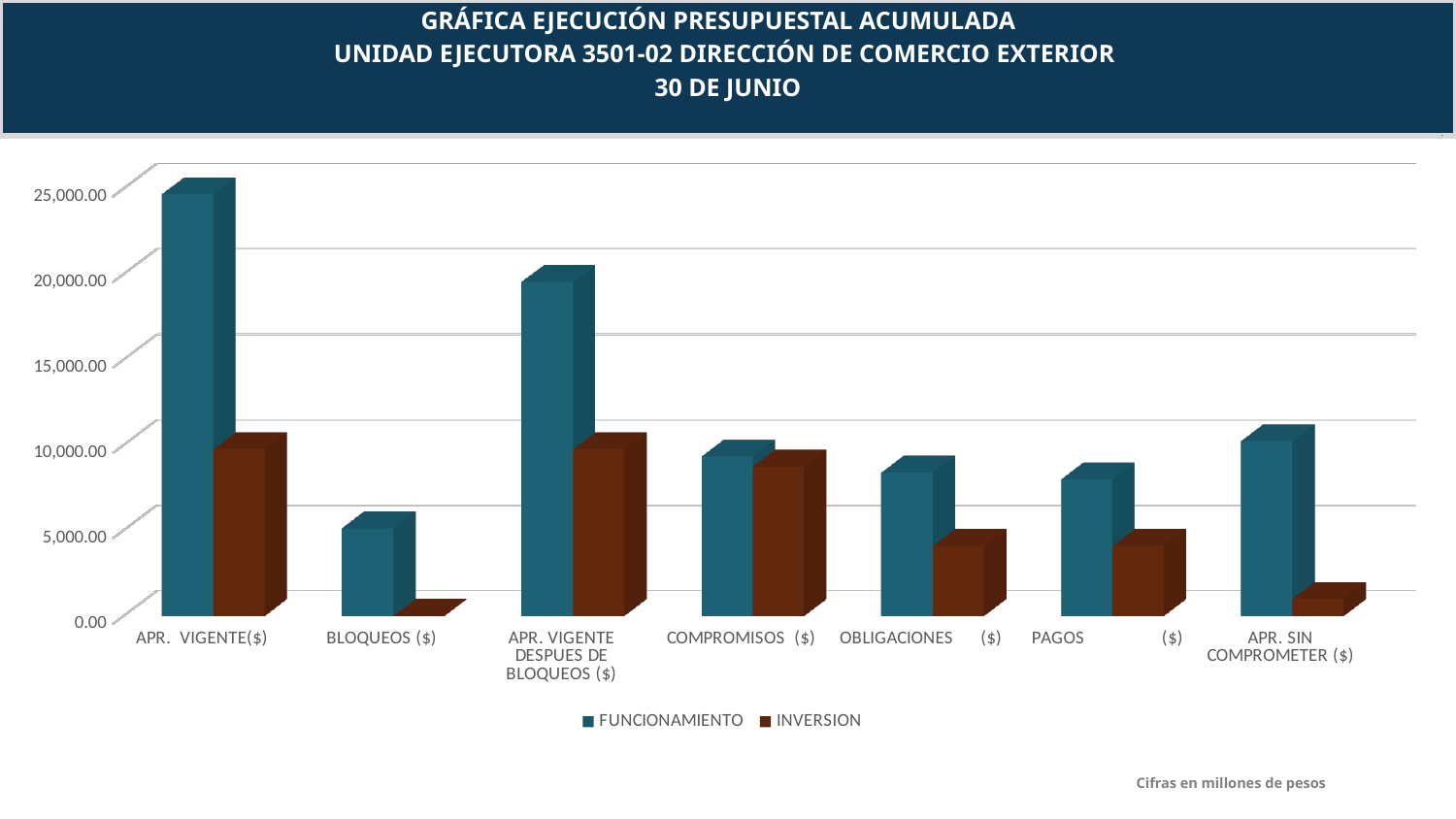
Which series is shown in brown in the legend? INVERSION Is the FUNCIONAMIENTO value for BLOQUEOS ($) greater or less than 10,000.00? less For APR. VIGENTE($), which series has the larger value, FUNCIONAMIENTO or INVERSION? FUNCIONAMIENTO Is the INVERSION value for OBLIGACIONES ($) greater or less than 5,000.00? less Is the FUNCIONAMIENTO value for APR. VIGENTE DESPUES DE BLOQUEOS ($) greater or less than 15,000.00? greater How many categories are shown along the x axis? 7 What kind of chart is shown on the slide? bar chart How many series does the legend list? 2 Which category has the highest FUNCIONAMIENTO value? APR. VIGENTE($) Which category has the lowest INVERSION value? BLOQUEOS ($) Which category has the lowest FUNCIONAMIENTO value? BLOQUEOS ($)